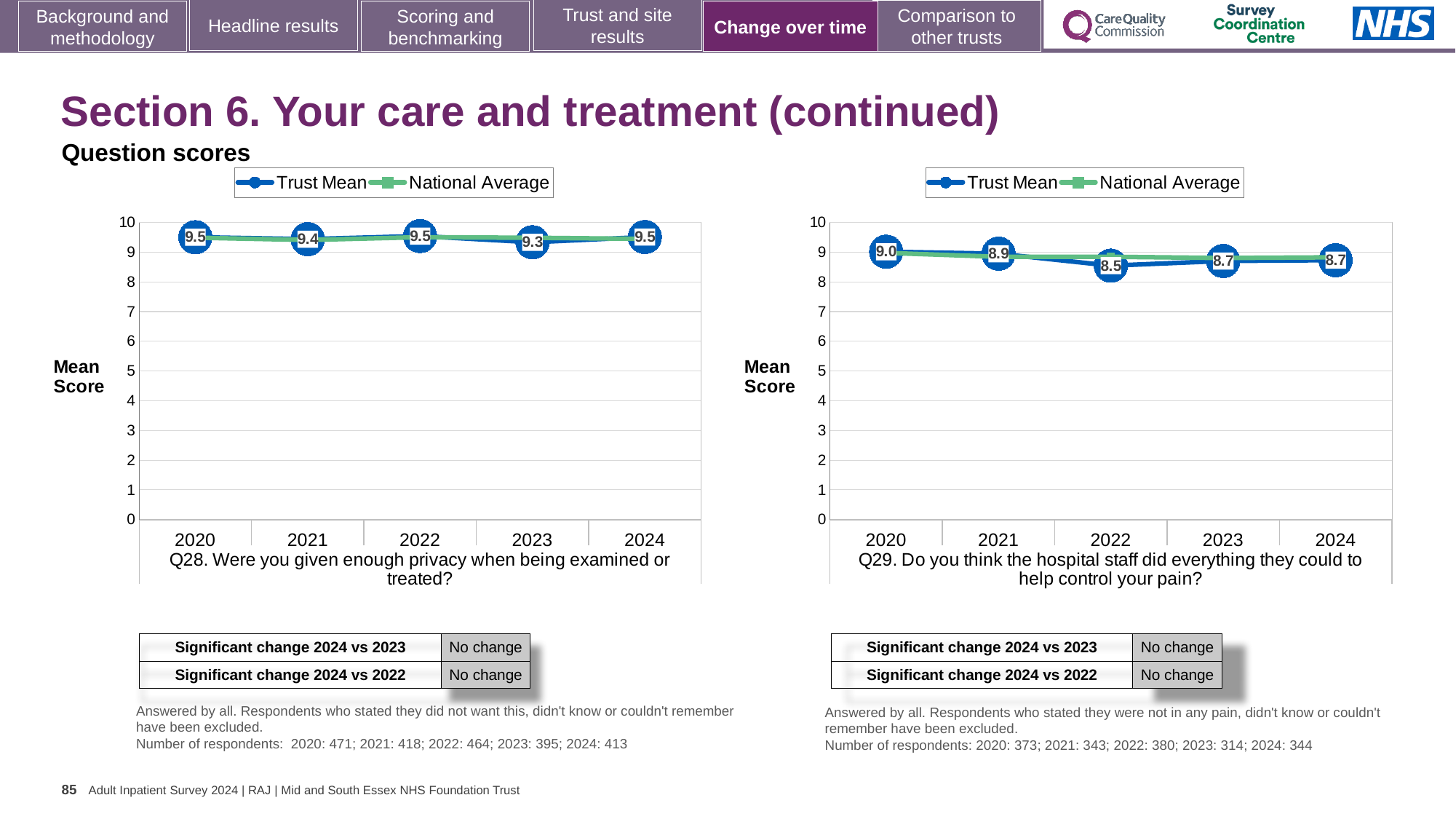
In the Q28 chart, is the Trust Mean score higher in 2022 or 2023? 2022 In the Q29 chart, which year has the highest Trust Mean score? 2020 In the Q28 chart, what is the Trust Mean score for 2023? 9.3 In the Q29 chart, what is the Trust Mean score for 2020? 9.0 How many years are plotted on the x axis of the Q29 chart? 5 In the Q29 chart, what is the Trust Mean score for 2022? 8.5 In the Q29 chart, what is the difference between the Trust Mean scores for 2020 and 2022? 0.5 What type of chart is used for Q29? Line chart In the Q28 chart, which year has the lowest Trust Mean score? 2023 How many series does the legend of the Q28 chart list? 2 In the Q28 chart, what is the Trust Mean score for 2024? 9.5 In the Q29 chart, which year has the lowest Trust Mean score? 2022